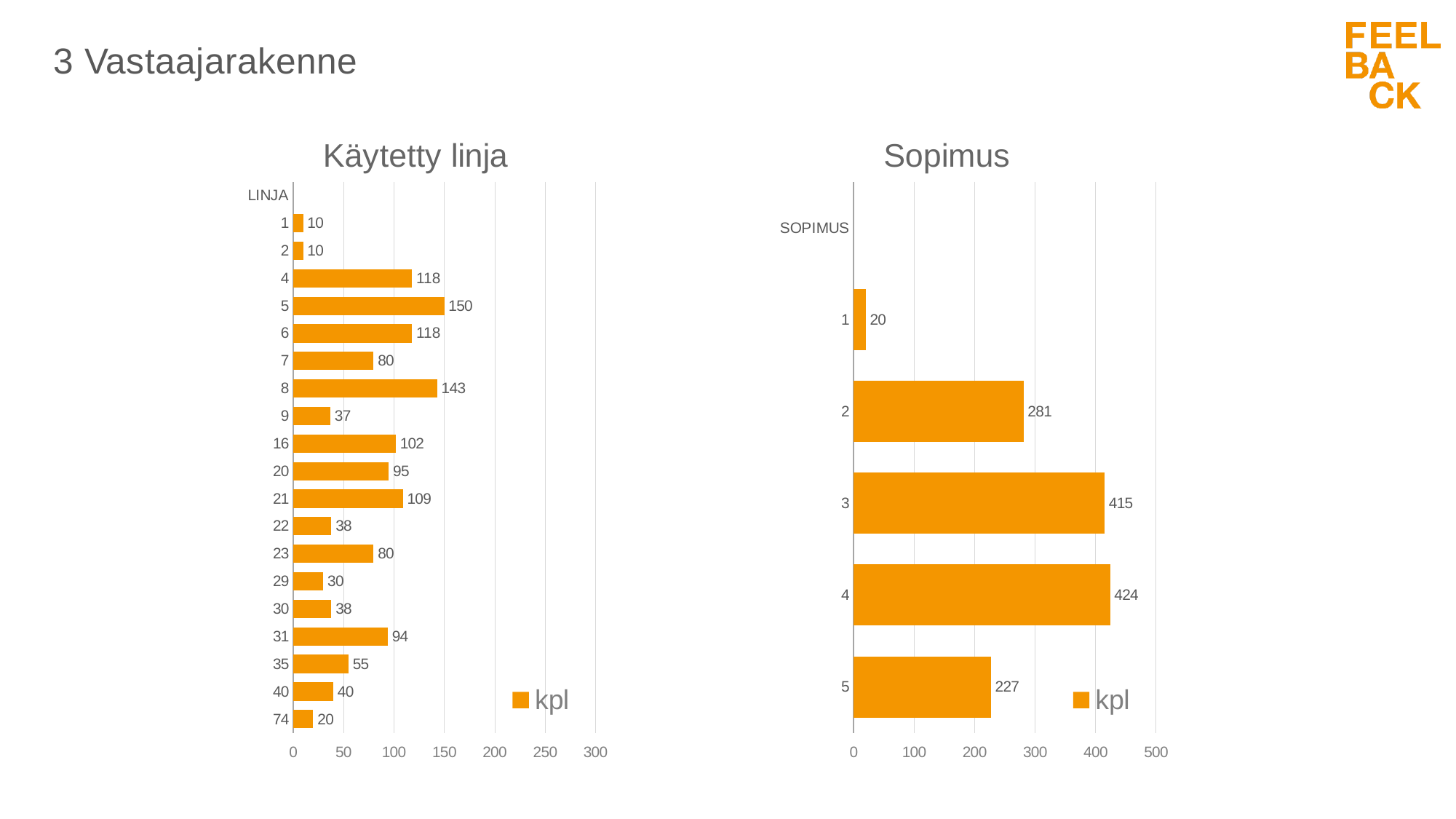
In the Sopimus chart, what is the value for sopimus 2? 281 In the Sopimus chart, which sopimus has the highest value? 4 In the Käytetty linja chart, which has the larger value, linja 16 or linja 20? linja 16 In the Käytetty linja chart, what is the value for linja 8? 143 In the Käytetty linja chart, which linja has the highest value? 5 In the Käytetty linja chart, what is the difference between the values for linja 5 and linja 7? 70 In the Sopimus chart, which sopimus has the lowest value? 1 What series name does the legend of the Käytetty linja chart show? kpl In the Sopimus chart, which has the larger value, sopimus 3 or sopimus 5? sopimus 3 What kind of chart is the Sopimus chart? bar chart In the Sopimus chart, what is the difference between the values for sopimus 4 and sopimus 5? 197 In the Käytetty linja chart, what is the value for linja 21? 109